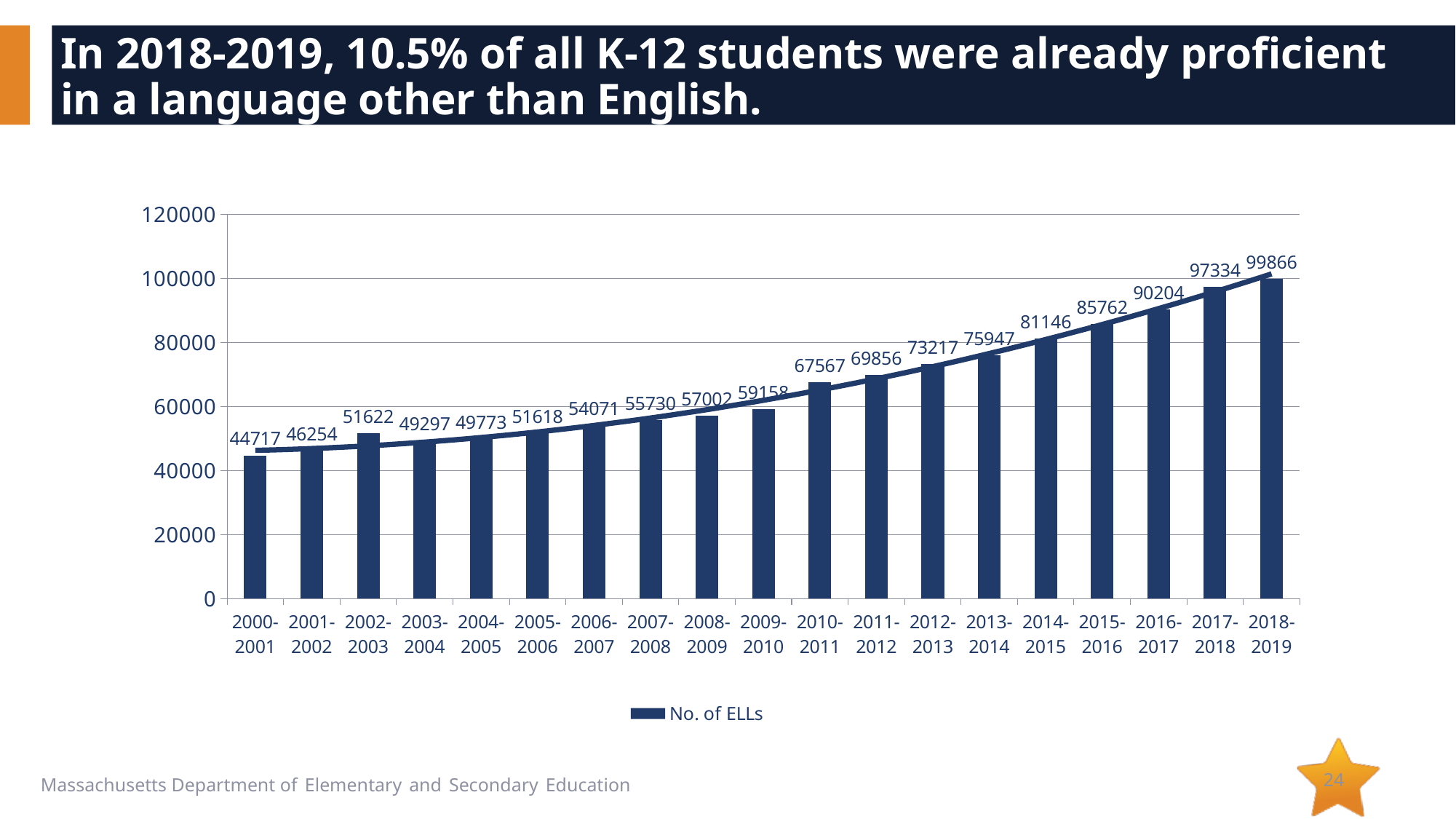
Which school year has the lowest number of ELLs? 2000-2001 What kind of chart is shown on the slide? bar chart Which has more ELLs, 2002-2003 or 2003-2004? 2002-2003 What is the difference in the number of ELLs between 2010-2011 and 2009-2010? 8409 What is the number of ELLs for 2018-2019? 99866 How many school years are shown on the x axis? 19 What is the number of ELLs for 2010-2011? 67567 Is the number of ELLs for 2014-2015 greater or less than 80000? greater Which school year has the highest number of ELLs? 2018-2019 What is the difference in the number of ELLs between 2018-2019 and 2000-2001? 55149 What is the number of ELLs for 2004-2005? 49773 How many series does the legend list? 1